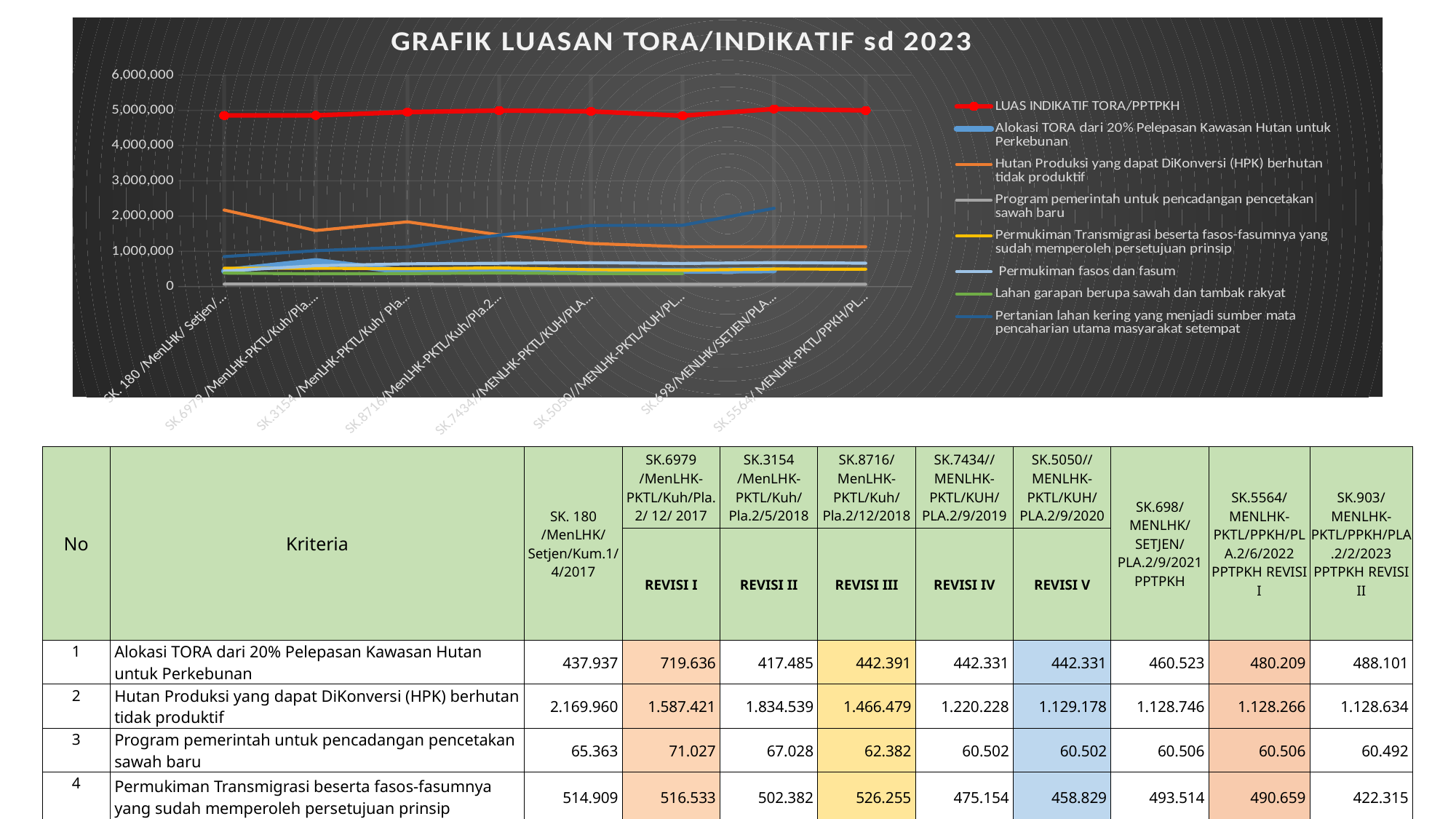
According to the table below the chart, what is the value of Hutan Produksi yang dapat DiKonversi (HPK) berhutan tidak produktif for REVISI I? 1.587.421 Is the value of Hutan Produksi yang dapat DiKonversi (HPK) berhutan tidak produktif at the first point greater or less than 2,000,000? greater What colour is the LUAS INDIKATIF TORA/PPTPKH line? red Does the Pertanian lahan kering yang menjadi sumber mata pencaharian utama masyarakat setempat line generally rise or fall along the x axis? rise According to the table below the chart, what is the value of Alokasi TORA dari 20% Pelepasan Kawasan Hutan untuk Perkebunan for SK. 180 /MenLHK/Setjen/Kum.1/4/2017? 437.937 Does the Hutan Produksi yang dapat DiKonversi (HPK) berhutan tidak produktif line generally rise or fall along the x axis? fall Which series has the highest values across the chart? LUAS INDIKATIF TORA/PPTPKH What type of chart is shown on the slide? line chart What is the title of the chart? GRAFIK LUASAN TORA/INDIKATIF sd 2023 How many data points does the LUAS INDIKATIF TORA/PPTPKH line have? 8 How many series does the chart legend list? 8 Is the value of LUAS INDIKATIF TORA/PPTPKH at the first point greater or less than 4,000,000? greater